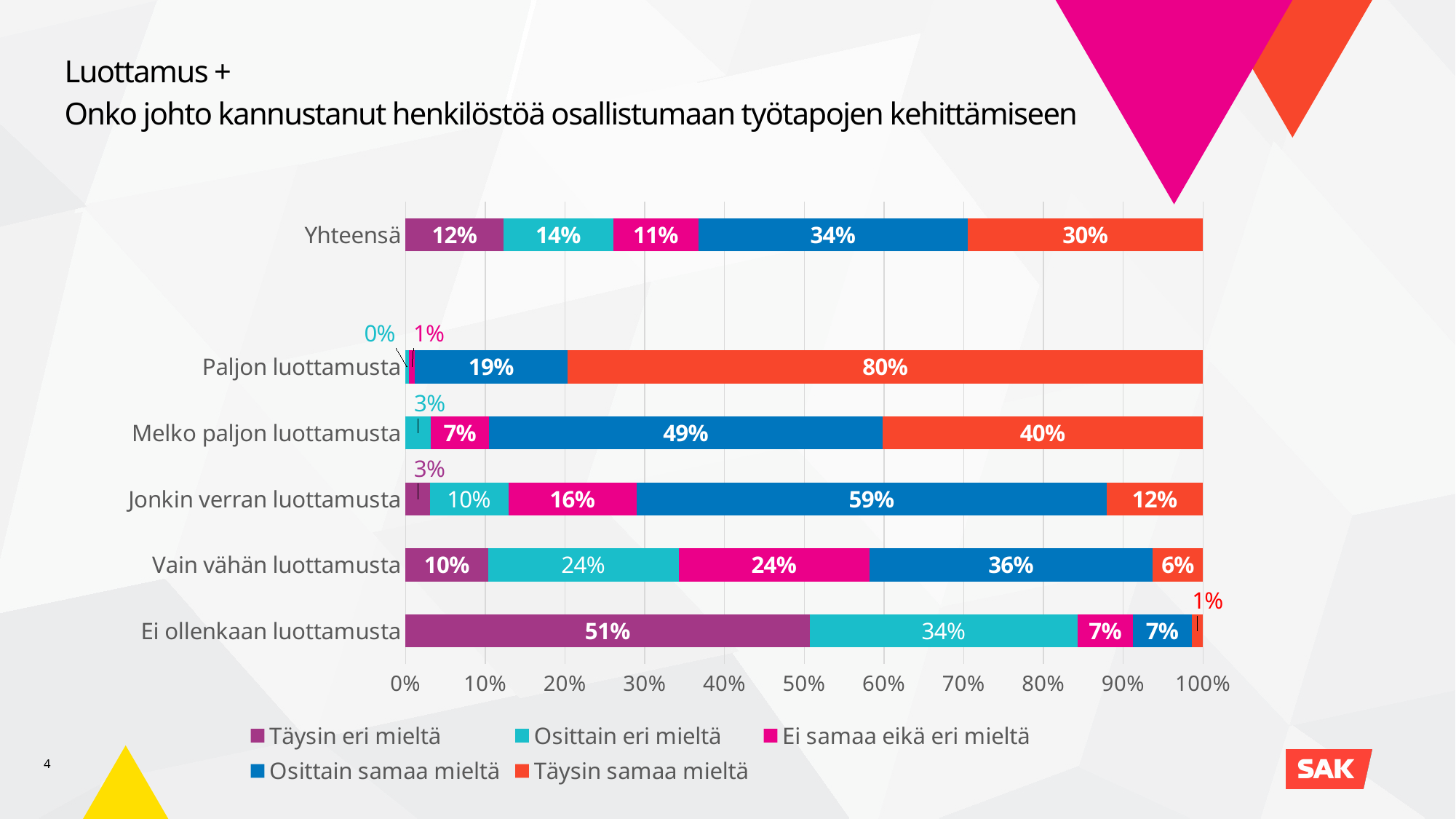
For 'Vain vähän luottamusta', which is larger: 'Osittain samaa mieltä' or 'Ei samaa eikä eri mieltä'? Osittain samaa mieltä What colour represents 'Täysin samaa mieltä' in the chart? Orange What is the 'Osittain samaa mieltä' value for 'Jonkin verran luottamusta'? 59% What is the 'Osittain samaa mieltä' value for 'Melko paljon luottamusta'? 49% For 'Yhteensä', how many percentage points larger is 'Täysin samaa mieltä' than 'Täysin eri mieltä'? 18 percentage points What percentage of respondents with 'Paljon luottamusta' answered 'Täysin samaa mieltä'? 80% Which category has the highest 'Täysin samaa mieltä' share? Paljon luottamusta How many series does the legend list? 5 How many categories are shown on the vertical axis of the chart? 6 What type of chart is shown on the slide? Stacked bar chart Which category has the lowest 'Täysin samaa mieltä' share? Ei ollenkaan luottamusta What is the 'Täysin eri mieltä' share for 'Ei ollenkaan luottamusta'? 51%